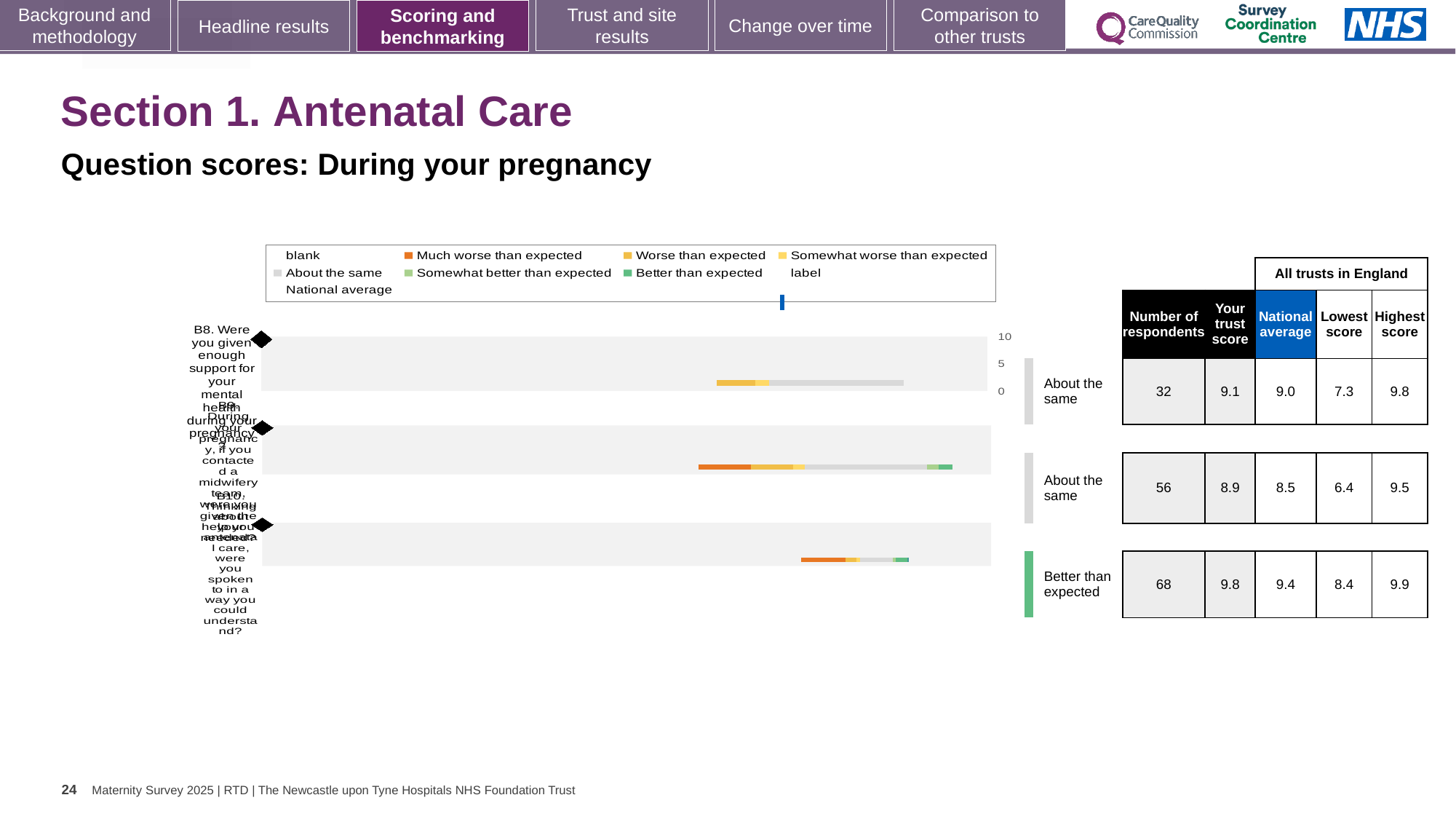
What kind of chart is shown on the slide? bar chart Which row has the highest trust score? the bottom row (9.8) What is the lowest score among all trusts in England for the bottom row of the table? 8.4 How many question rows (bars) are plotted in the chart? 3 Which row has the fewest respondents? the top row (B8, 32 respondents) What benchmark rating is given to the bottom row of the chart? Better than expected What is the highest score among all trusts in England for the second row of the table? 9.5 What is the trust score for the top row (B8, support for your mental health during pregnancy)? 9.1 What is the difference between the trust score and the national average for the second row? 0.4 What is the national average for the second row of the table? 8.5 What is the number of respondents for the top row (B8, support for your mental health during pregnancy)? 32 For the bottom row, which is larger: the trust score or the national average? the trust score (9.8)